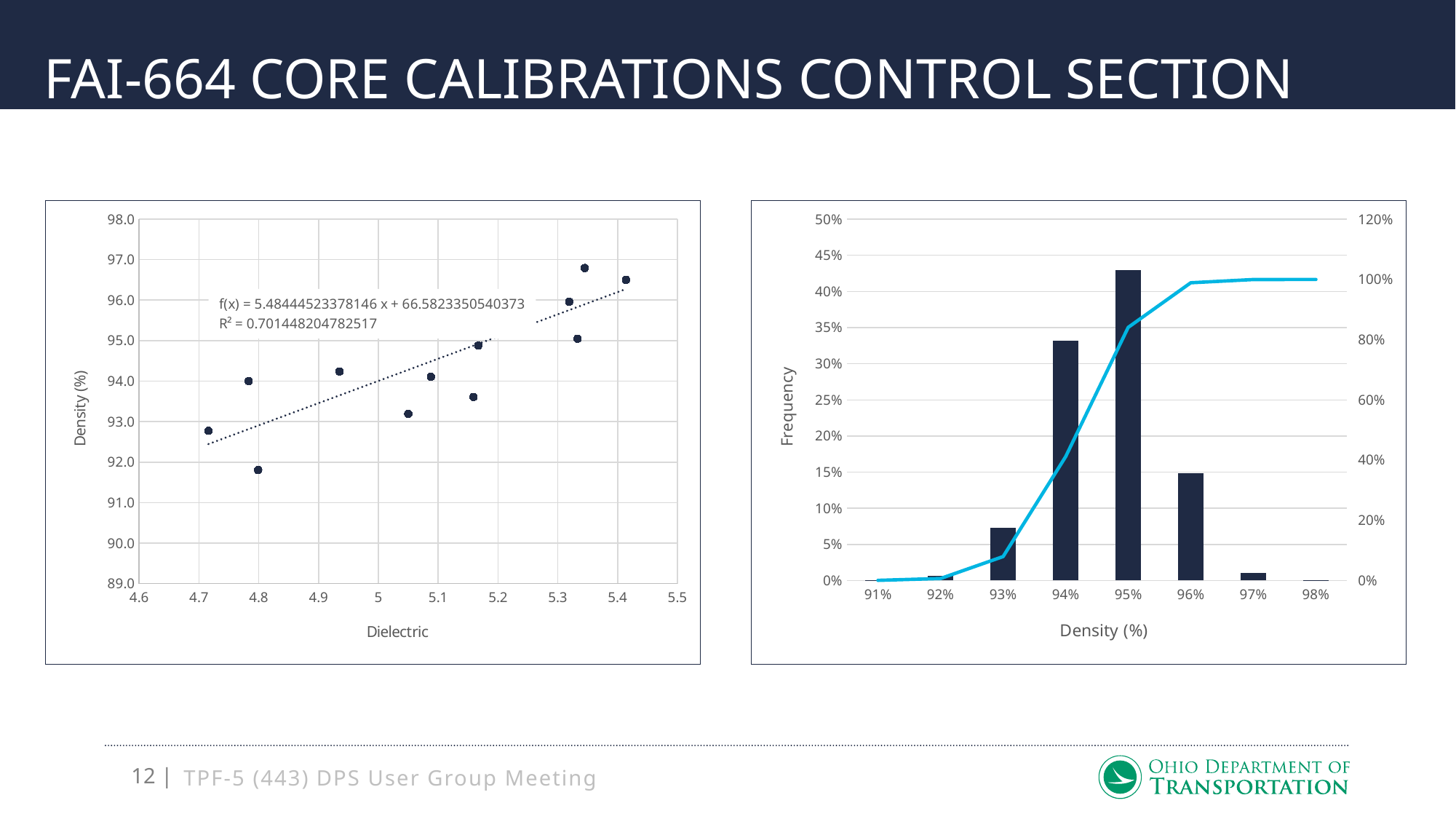
On the right chart, is the frequency for 93% greater or less than 10%? less On the right chart, which density category has the highest frequency? 95% On the left chart, does density rise or fall as dielectric increases? rise On the right chart, how many density categories are shown on the x-axis? 8 On the right chart, is the frequency for 94% greater or less than 30%? greater What type of chart is the right chart? combination bar and line chart On the right chart, which has the higher frequency, 94% or 96%? 94% On the left chart, what is the R² value shown for the trendline? 0.701448204782517 What type of chart is the left chart? scatter plot On the right chart, what is the y-axis label on the left side? Frequency On the left chart, what is the trendline equation shown? f(x) = 5.48444523378146 x + 66.5823350540373 On the left chart, what is the x-axis label? Dielectric